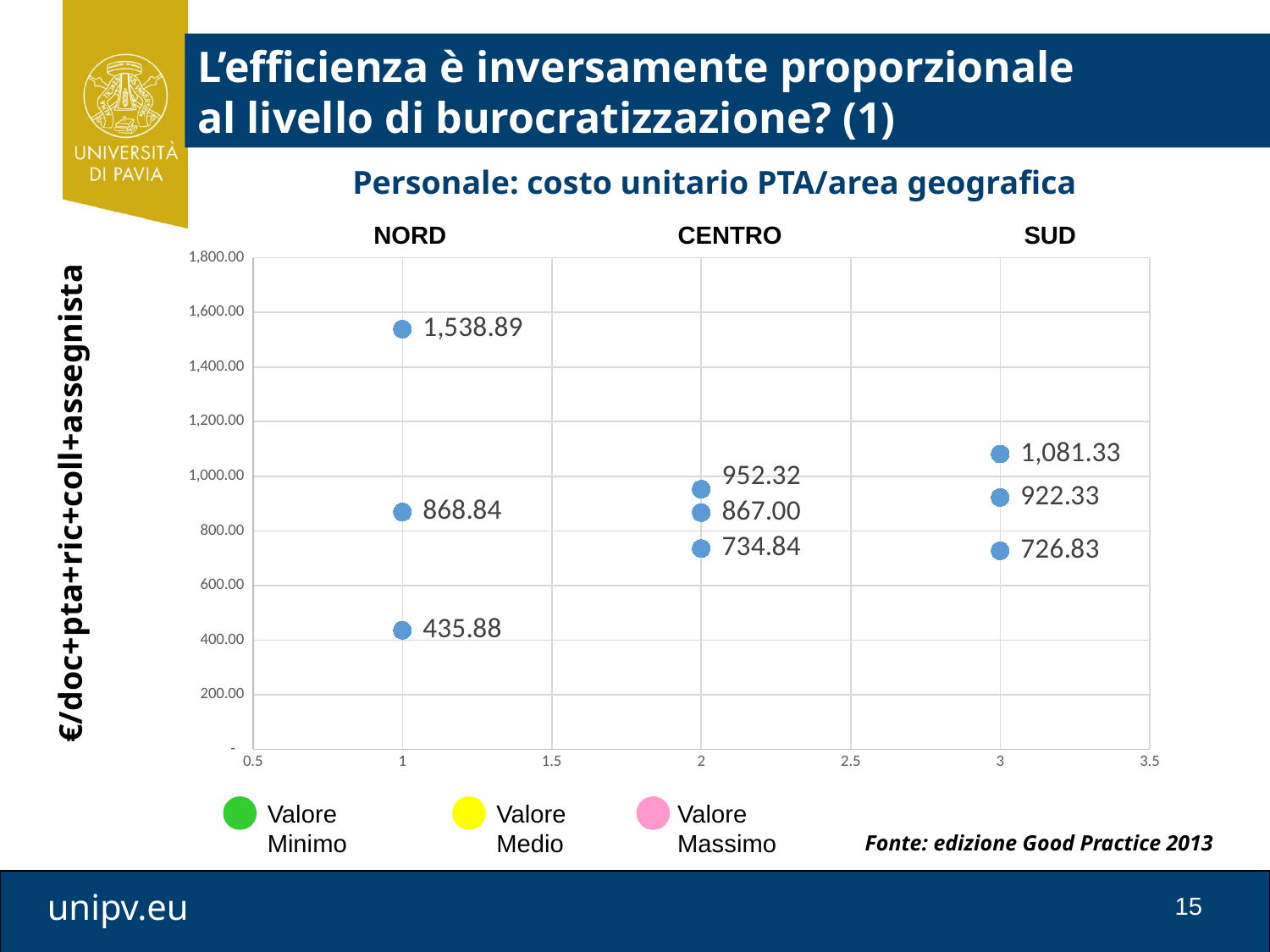
What is the difference between the lowest value for CENTRO (734.84) and the lowest value for NORD (435.88)? 298.96 Which geographic area has the highest single value plotted on the chart? NORD Which is larger: the highest value for CENTRO or the highest value for SUD? SUD What is the difference between the highest value for NORD (1,538.89) and the highest value for SUD (1,081.33)? 457.56 What is the lowest value shown for SUD? 726.83 What is the highest value shown for NORD? 1,538.89 How many geographic areas are shown on the chart? 3 Which geographic area has the lowest single value plotted on the chart? NORD Is the lowest value for NORD greater or less than 600.00? less How many entries does the legend below the chart list? 3 What is the middle (Valore Medio) value shown for CENTRO? 867.00 What is the title of the chart? Personale: costo unitario PTA/area geografica